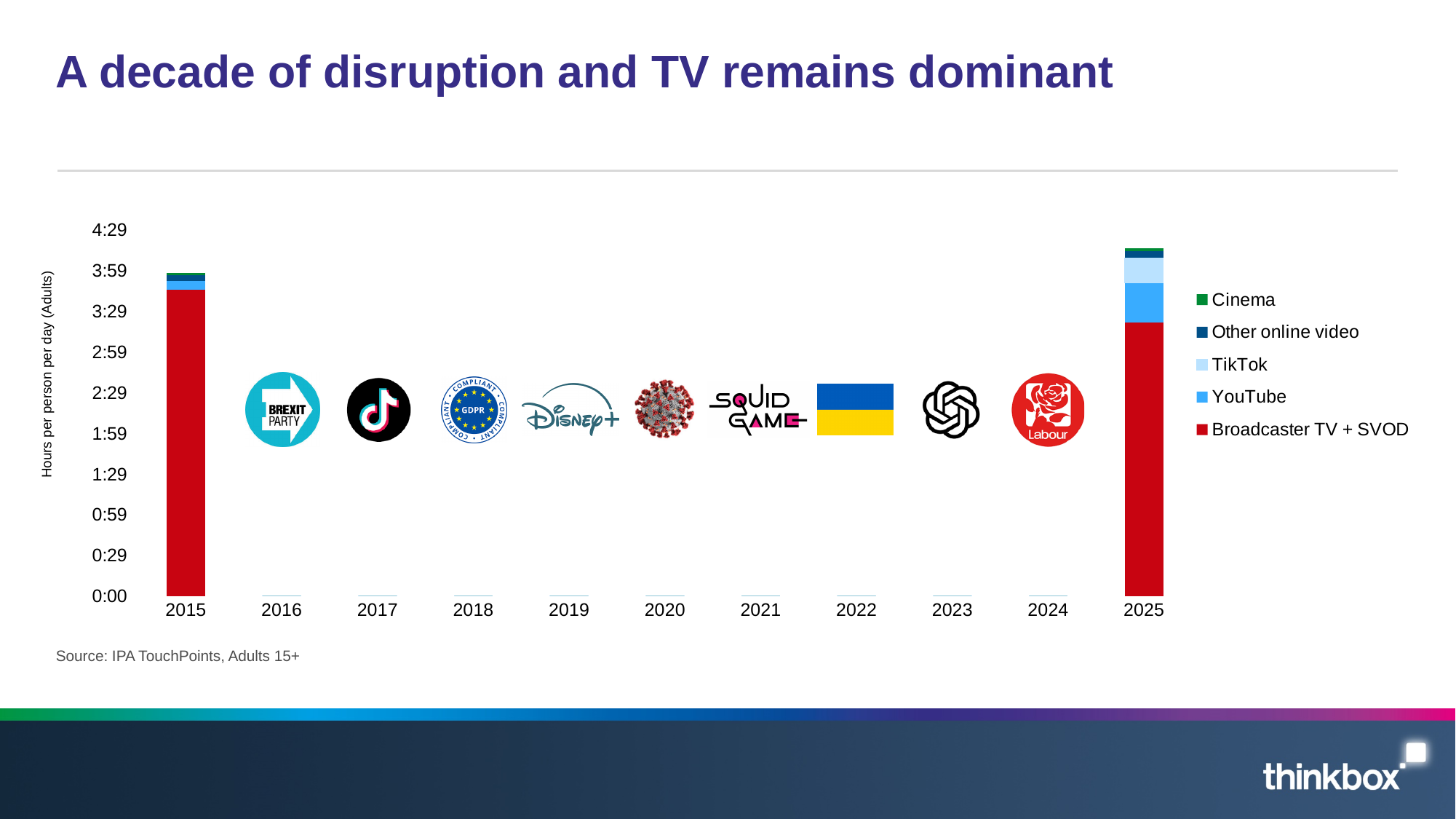
How many series does the legend list? 5 What is the label on the vertical axis? Hours per person per day (Adults) How many years are labelled along the x axis? 11 Is the total of the 2025 stacked bar greater or less than 3:59? greater Which series is shown in red in the legend? Broadcaster TV + SVOD Is the total of the 2015 stacked bar greater or less than 3:29? greater Is the Broadcaster TV + SVOD value for 2015 greater or less than 3:29? greater Which year has the tallest stacked bar? 2025 Is the total stacked bar for 2025 taller or shorter than the one for 2015? Taller Which series makes up the largest segment of the 2025 bar? Broadcaster TV + SVOD What kind of chart is shown on the slide? Stacked bar chart Is the YouTube segment larger in 2025 or in 2015? 2025